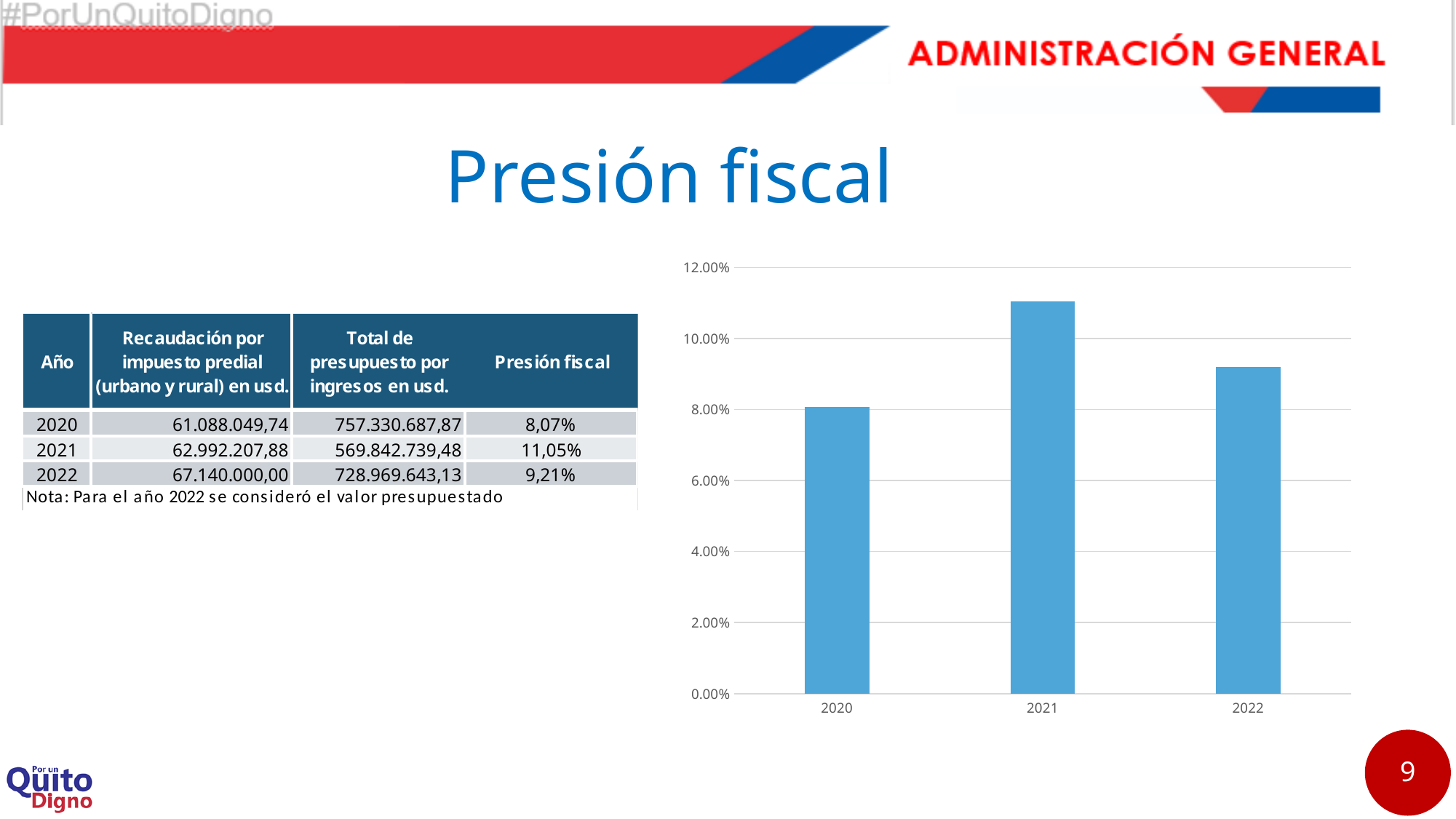
How many years are plotted in the bar chart? 3 Which year has the highest bar in the chart? 2021 What type of chart is shown on the slide? bar chart What is the presión fiscal value for 2021 shown on the slide? 11,05% Is the bar for 2022 greater or less than 10.00%? less Is the bar for 2021 greater or less than 10.00%? greater Which bar is taller, 2022 or 2020? 2022 Is the bar for 2020 greater or less than 10.00%? less What is the title of the slide containing the chart? Presión fiscal Which year has the lowest bar in the chart? 2020 What is the presión fiscal value for 2020 shown on the slide? 8,07%